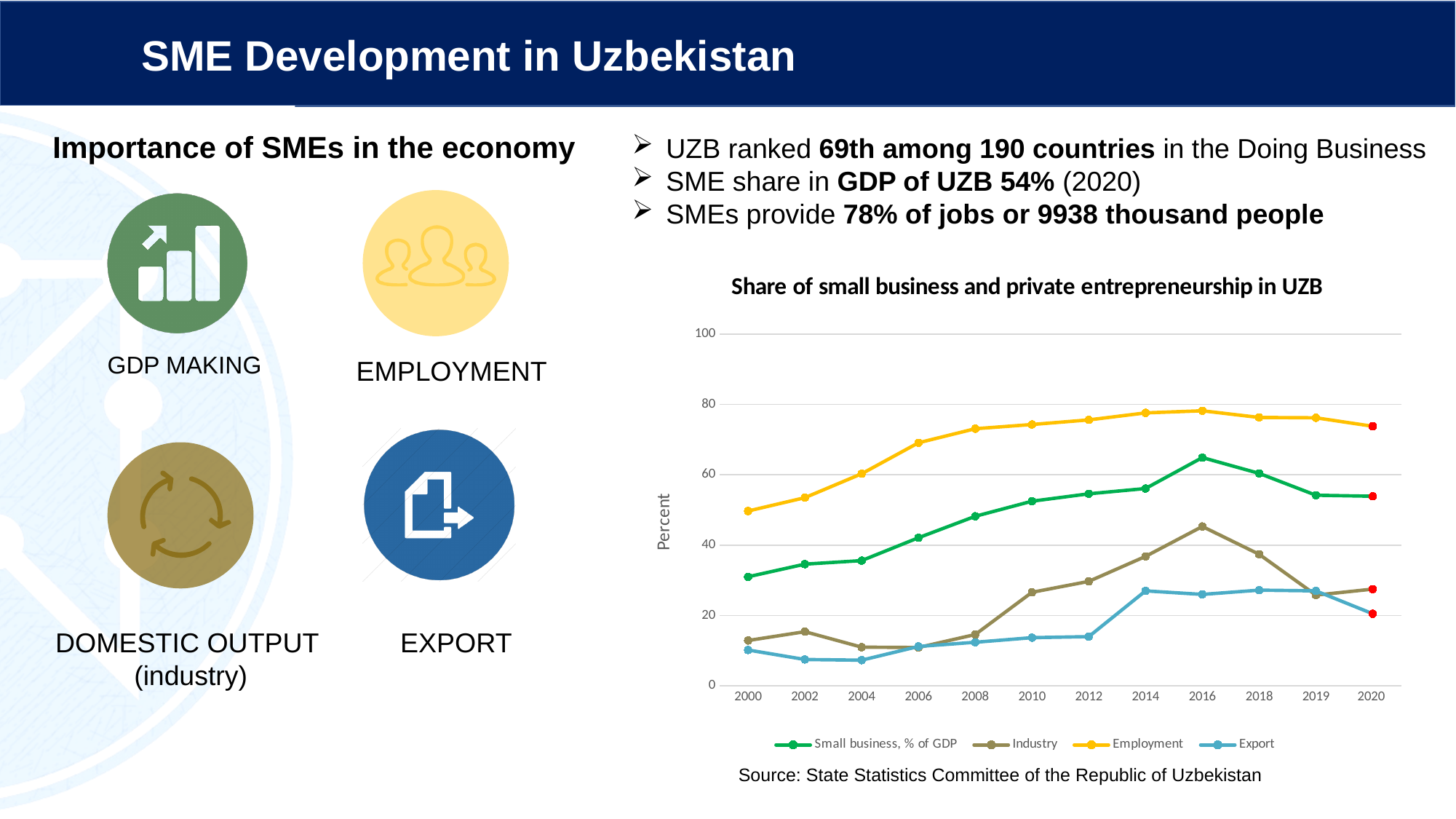
What is the title of the chart? Share of small business and private entrepreneurship in UZB Which series has the highest value in 2020? Employment How many years are shown on the x axis of the chart? 12 Which series has the lowest value in 2000? Export Is the value for Employment in 2016 greater or less than 60? greater Does the Employment series rise or fall from 2000 to 2016? rise Which is larger in 2016, Small business, % of GDP or Industry? Small business, % of GDP Which series has the lowest value in 2020? Export What kind of chart is shown on the slide? line chart How many series does the chart legend list? 4 Is the value for Industry in 2016 greater or less than 40? greater Is the value for Export in 2004 greater or less than 20? less